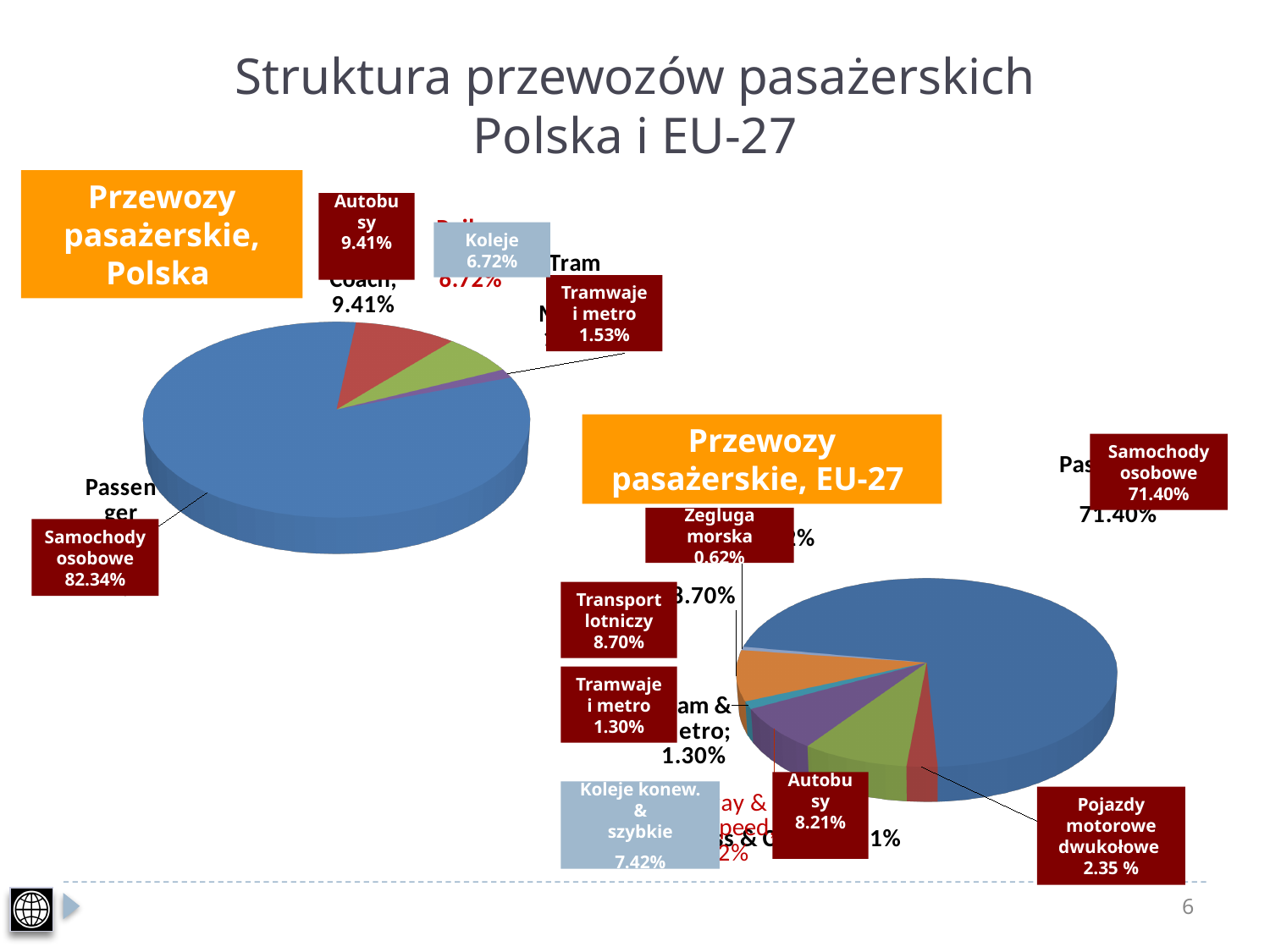
In the 'Przewozy pasażerskie, Polska' chart, what share do Samochody osobowe have? 82.34% In the 'Przewozy pasażerskie, Polska' chart, what is the value for Autobusy? 9.41% In the 'Przewozy pasażerskie, EU-27' chart, what is the value for Transport lotniczy? 8.70% In the 'Przewozy pasażerskie, Polska' chart, what is the difference between Autobusy and Koleje? 2.69% In the 'Przewozy pasażerskie, EU-27' chart, which category has the smallest share? Żegluga morska In the 'Przewozy pasażerskie, EU-27' chart, what is the value for Pojazdy motorowe dwukołowe? 2.35 % How many categories does the 'Przewozy pasażerskie, EU-27' chart show? 7 In the 'Przewozy pasażerskie, Polska' chart, what is the value for Koleje? 6.72% What type of chart is used for 'Przewozy pasażerskie, Polska'? Pie chart In the 'Przewozy pasażerskie, EU-27' chart, what is the value for Samochody osobowe? 71.40% In the 'Przewozy pasażerskie, Polska' chart, which category has the smallest share? Tramwaje i metro In the 'Przewozy pasażerskie, EU-27' chart, which is larger: Autobusy or Koleje konew. & szybkie? Autobusy